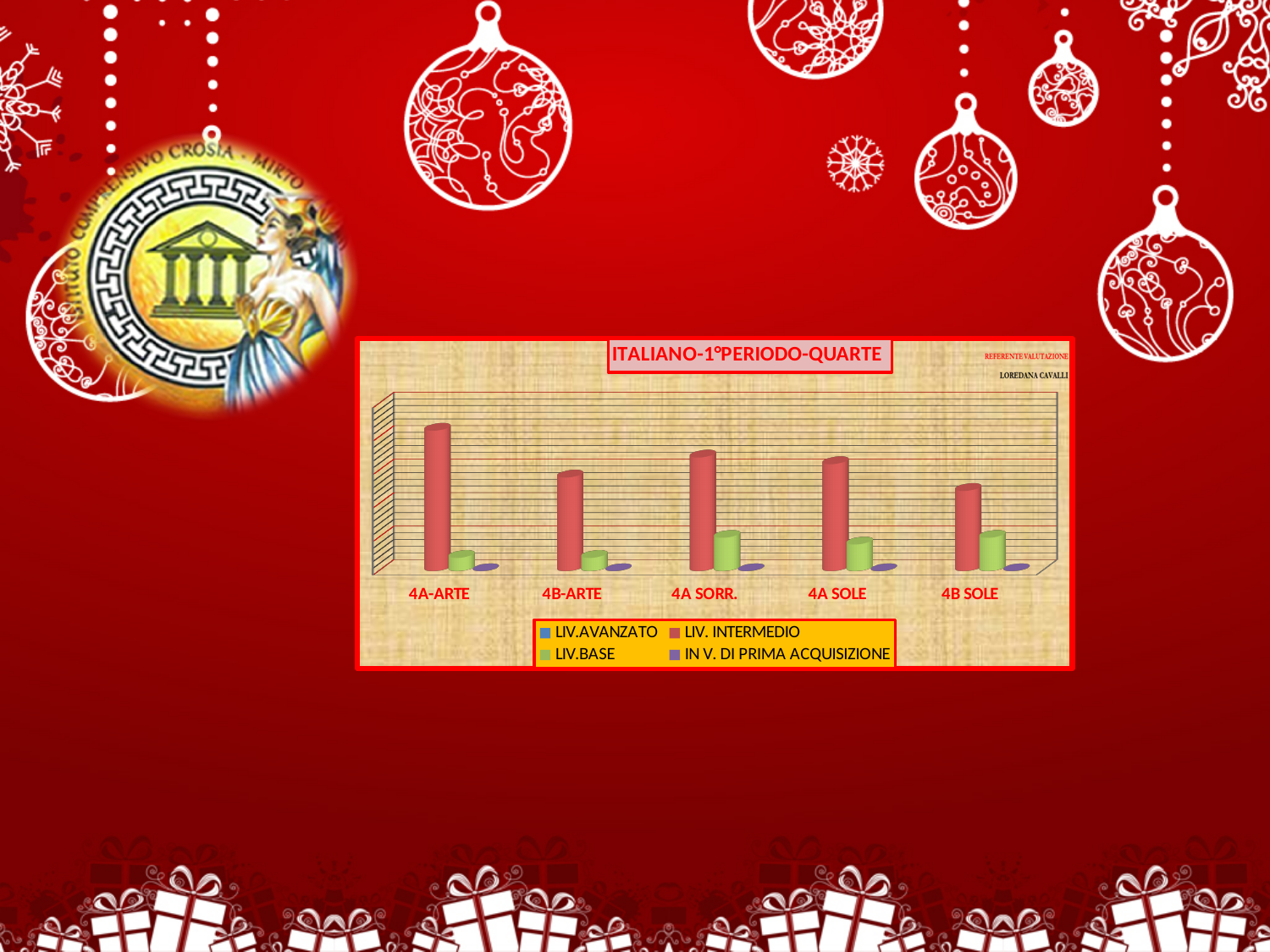
Which class has the lowest LIV. INTERMEDIO bar? 4B SOLE For 4A SORR., which is larger, the LIV. INTERMEDIO bar or the LIV.BASE bar? LIV. INTERMEDIO Which is larger, the LIV. INTERMEDIO bar for 4A SOLE or for 4B SOLE? 4A SOLE What is the title of the chart? ITALIANO-1°PERIODO-QUARTE What kind of chart is shown on the slide? bar chart How many series does the chart's legend list? 4 How many categories (classes) are shown on the x axis of the chart? 5 Which series is shown in green in the legend? LIV.BASE Which is larger, the LIV.BASE bar for 4A SOLE or the LIV. INTERMEDIO bar for 4A SOLE? LIV. INTERMEDIO Which class has the highest LIV. INTERMEDIO bar? 4A-ARTE Which series has the tallest bars across all classes in the chart? LIV. INTERMEDIO